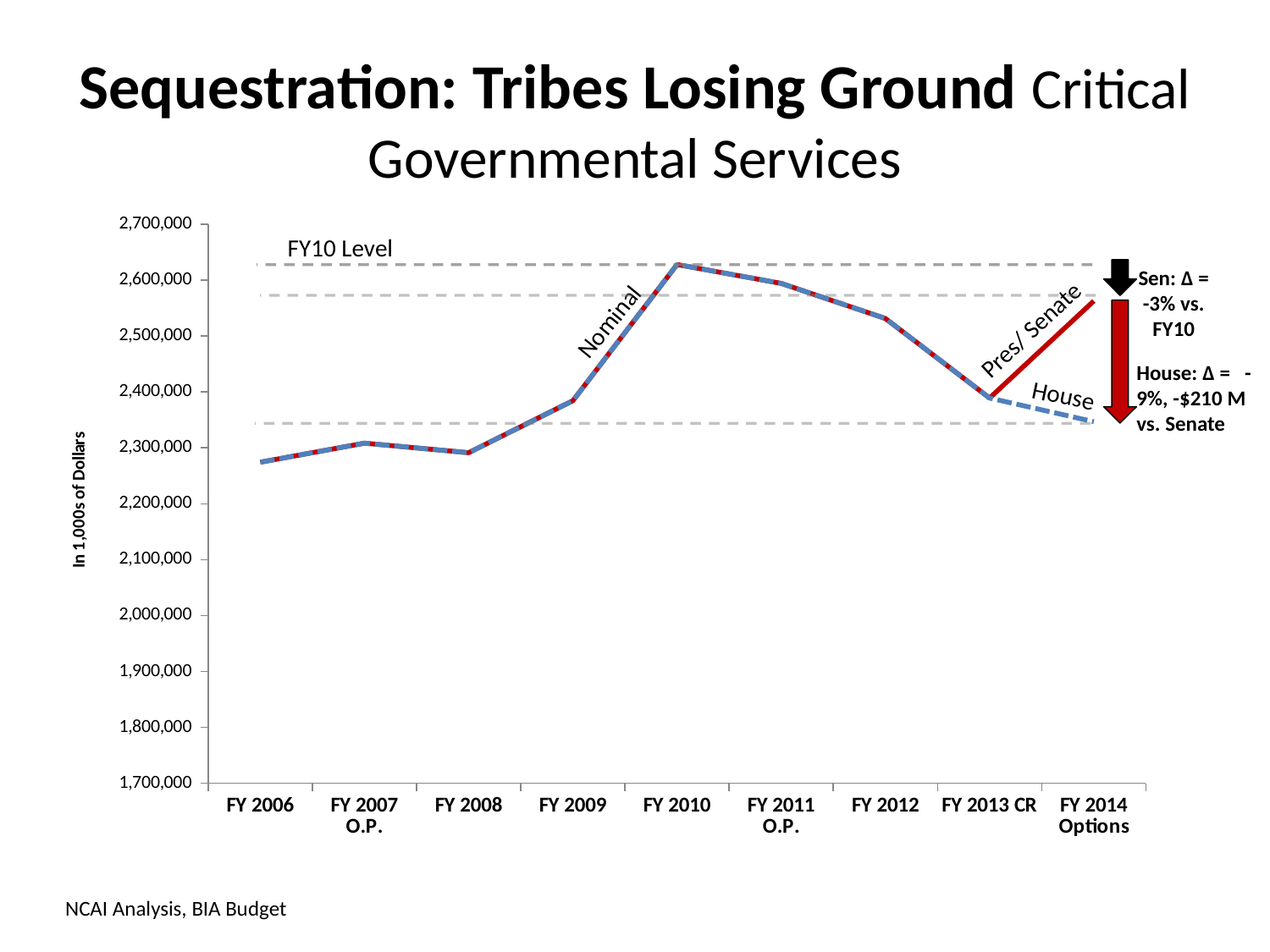
Is the value for FY 2011 O.P. greater or less than 2,500,000? greater Which is larger, the value for FY 2009 or the value for FY 2012? FY 2012 Which is larger, the value for FY 2010 or the value for FY 2012? FY 2010 What is the label on the vertical axis? In 1,000s of Dollars Which fiscal year has the highest value on the chart? FY 2010 What are the two FY 2014 options labeled on the chart? Pres/ Senate and House Do the values rise or fall from FY 2010 to FY 2013 CR? fall What kind of chart is shown on the slide? line chart Is the value for FY 2012 greater or less than 2,500,000? greater How many fiscal year categories are shown on the x axis? 9 Is the value for FY 2006 greater or less than 2,300,000? less